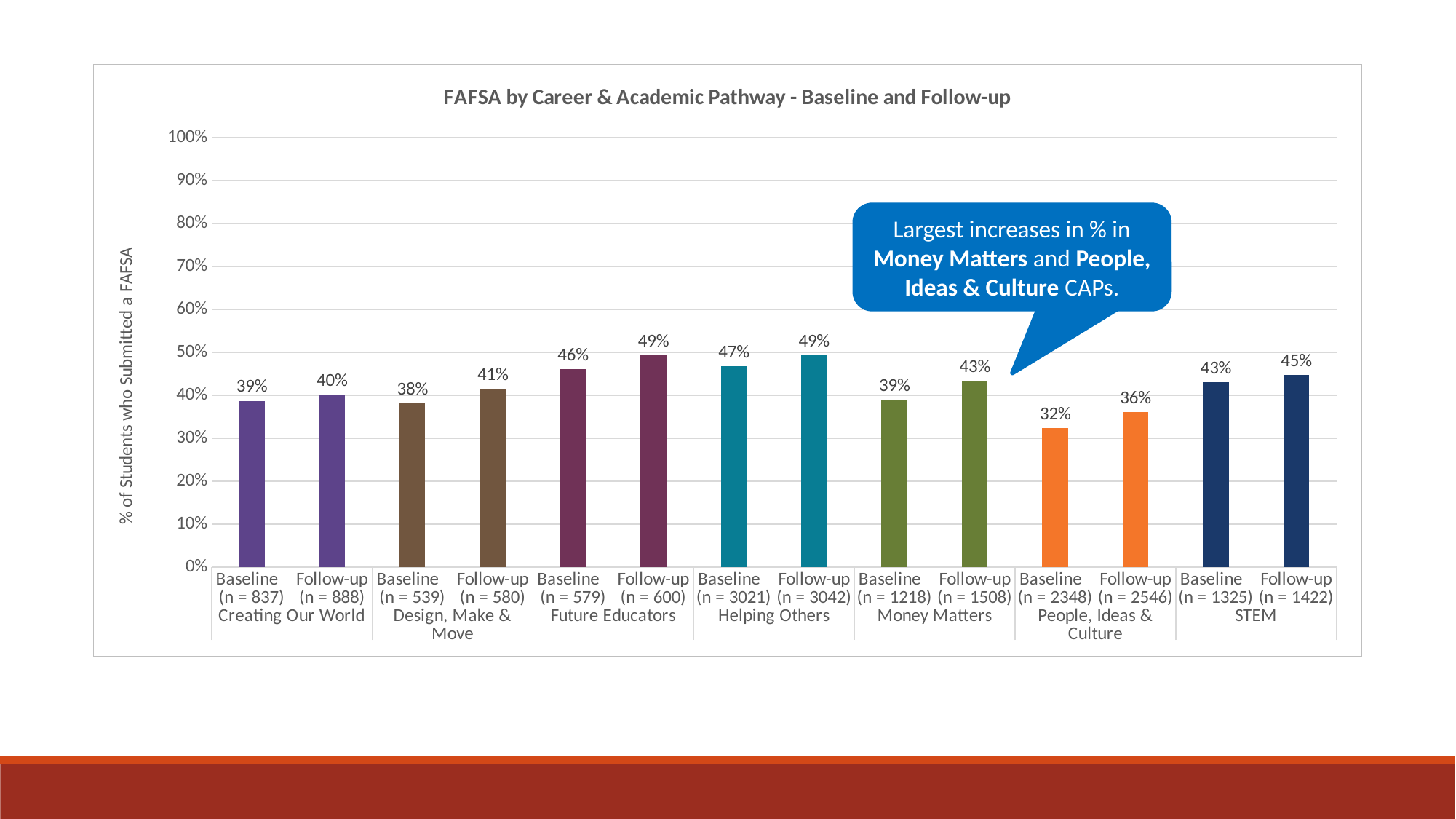
Which is larger, the Follow-up value for Helping Others or the Follow-up value for STEM? Helping Others What is the Baseline value for People, Ideas & Culture? 32% What is the Follow-up value for STEM? 45% What is the sample size (n) for the Helping Others Follow-up bar? 3042 What kind of chart is shown? Bar chart What is the title of the chart? FAFSA by Career & Academic Pathway - Baseline and Follow-up How many pathways are shown on the x axis? 7 What is the difference between the Baseline and Follow-up values for Money Matters? 4% What is the difference between the Baseline and Follow-up values for People, Ideas & Culture? 4% Which pathway has the lowest Baseline value? People, Ideas & Culture What is the Follow-up value for Money Matters? 43% Is the Baseline value for Future Educators greater or less than 40%? greater